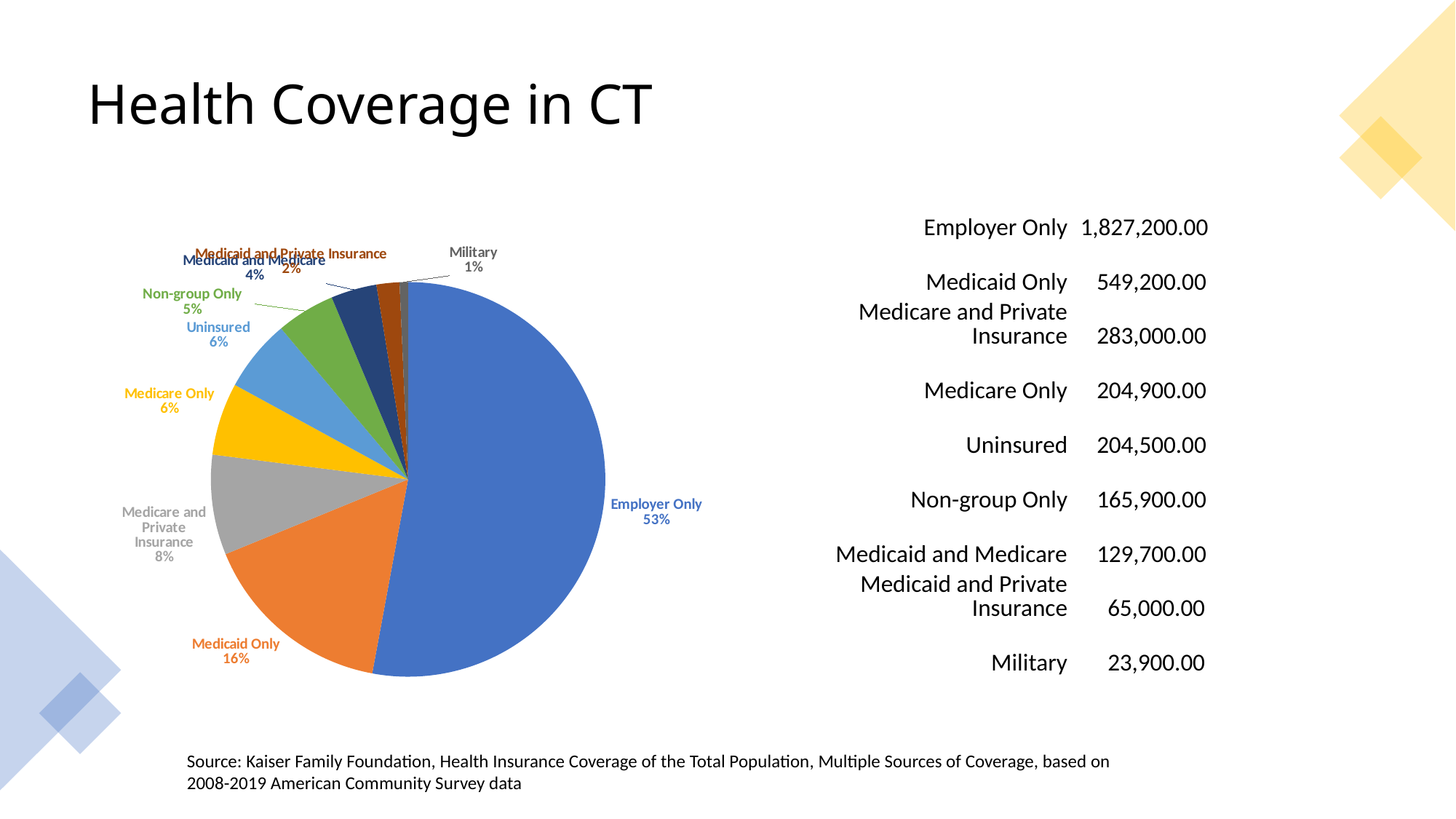
What is the title of the slide containing the pie chart? Health Coverage in CT What share of the pie does Employer Only represent? 53% Which slice is larger in the pie chart: Medicaid Only or Medicare and Private Insurance? Medicaid Only What percentage is shown for Medicare and Private Insurance in the pie chart? 8% What kind of chart is shown on the slide? pie chart How many slices does the pie chart have? 9 What percentage is shown for Medicaid Only in the pie chart? 16% Which category has the largest slice of the pie chart? Employer Only What percentage is shown for Non-group Only in the pie chart? 5% Which category has the smallest slice of the pie chart? Military What is the difference in percentage points between Employer Only and Medicaid Only in the pie chart? 37 What percentage is shown for Military in the pie chart? 1%